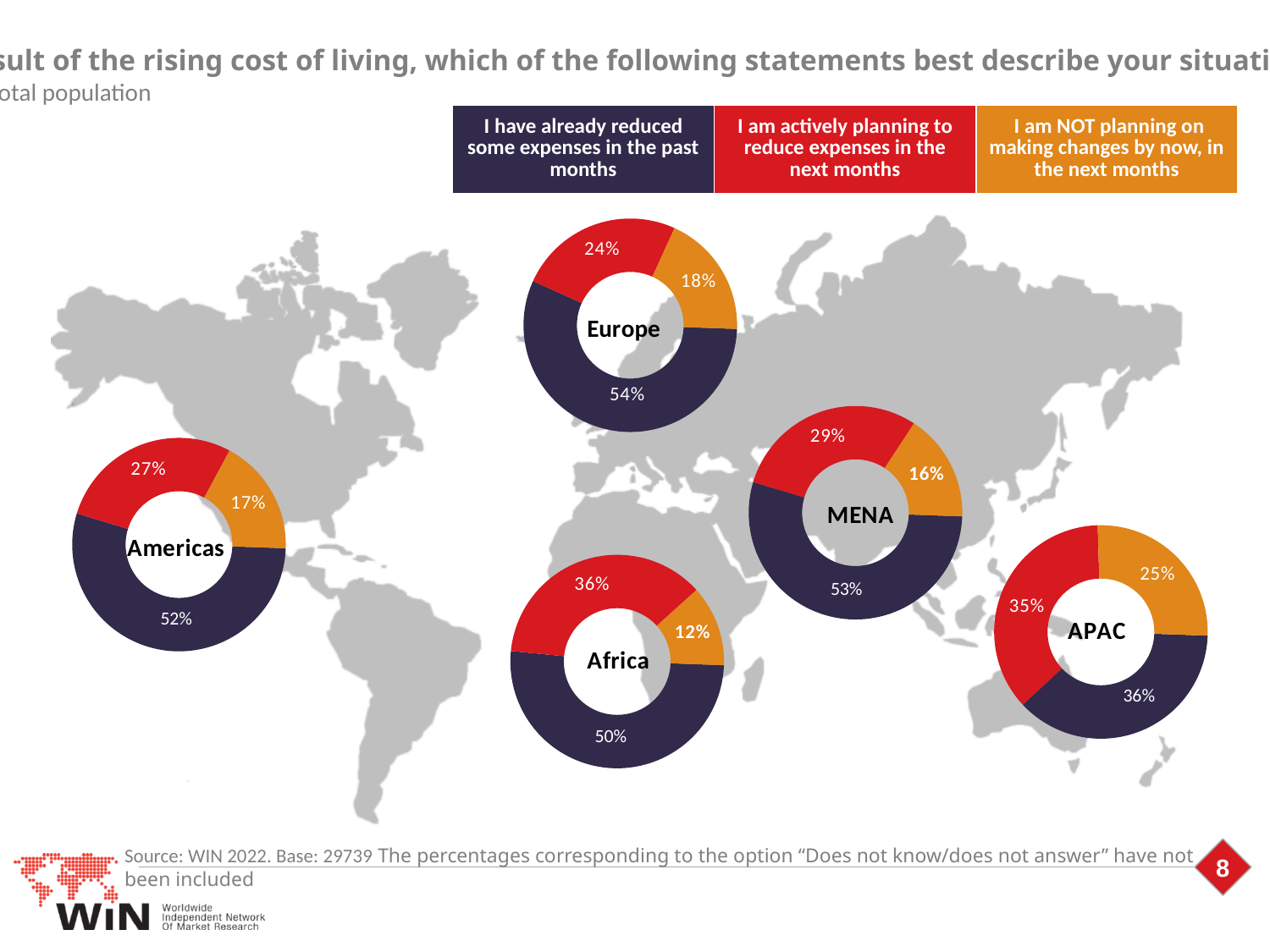
In the Europe chart, what percentage have already reduced some expenses in the past months? 54% In the Americas chart, what percentage have already reduced some expenses in the past months? 52% In the Africa chart, which is larger: the share actively planning to reduce expenses or the share NOT planning on making changes? Actively planning to reduce expenses In the Africa chart, what percentage are actively planning to reduce expenses in the next months? 36% What type of chart is used for each region on the slide? Donut (pie) chart In the MENA chart, what percentage are NOT planning on making changes by now, in the next months? 16% In the Europe chart, what is the difference between the share who have already reduced expenses and the share actively planning to reduce expenses? 30 percentage points Across the five regional charts, which region has the lowest share of people who are NOT planning on making changes? Africa In the APAC chart, what percentage are NOT planning on making changes by now, in the next months? 25% Across the five regional charts, which region has the highest share of people who have already reduced some expenses in the past months? Europe How many response categories does the legend list? 3 How many regional charts are shown on the slide? 5